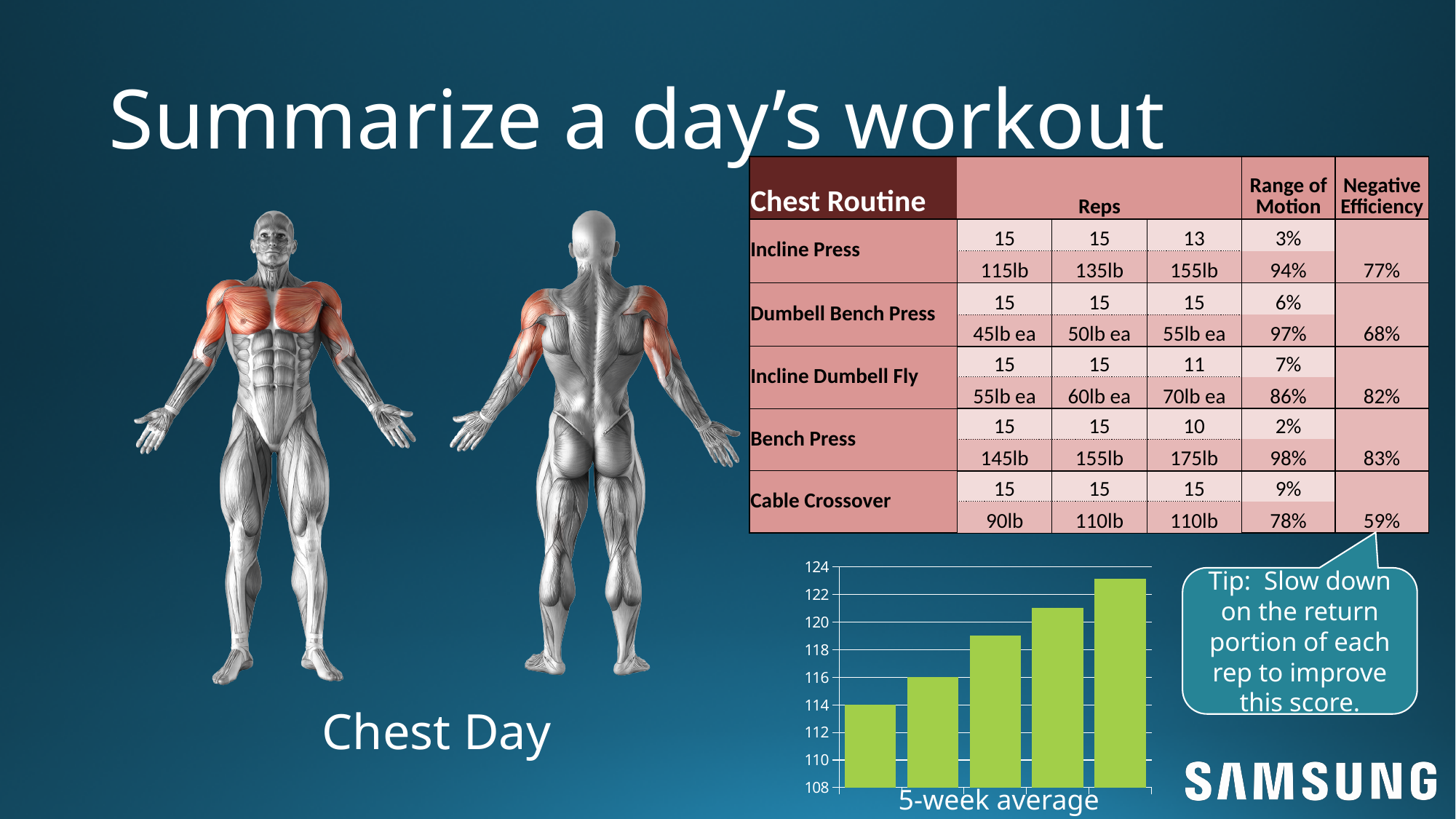
Is the value of the fourth bar greater or less than 120? greater What is the difference between the second bar and the first bar? 2 Is the value of the fifth (rightmost) bar greater or less than 122? greater What kind of chart is shown at the bottom of the slide? bar chart Is the value of the third bar greater or less than 118? greater What value does the second bar reach on the chart? 116 How many bars does the chart show? 5 What label appears below the x axis of the chart? 5-week average Which bar is the tallest in the chart? the fifth (rightmost) bar Which bar is the shortest in the chart? the first (leftmost) bar Do the bar values rise or fall from left to right across the chart? rise What value does the first (leftmost) bar reach on the chart? 114